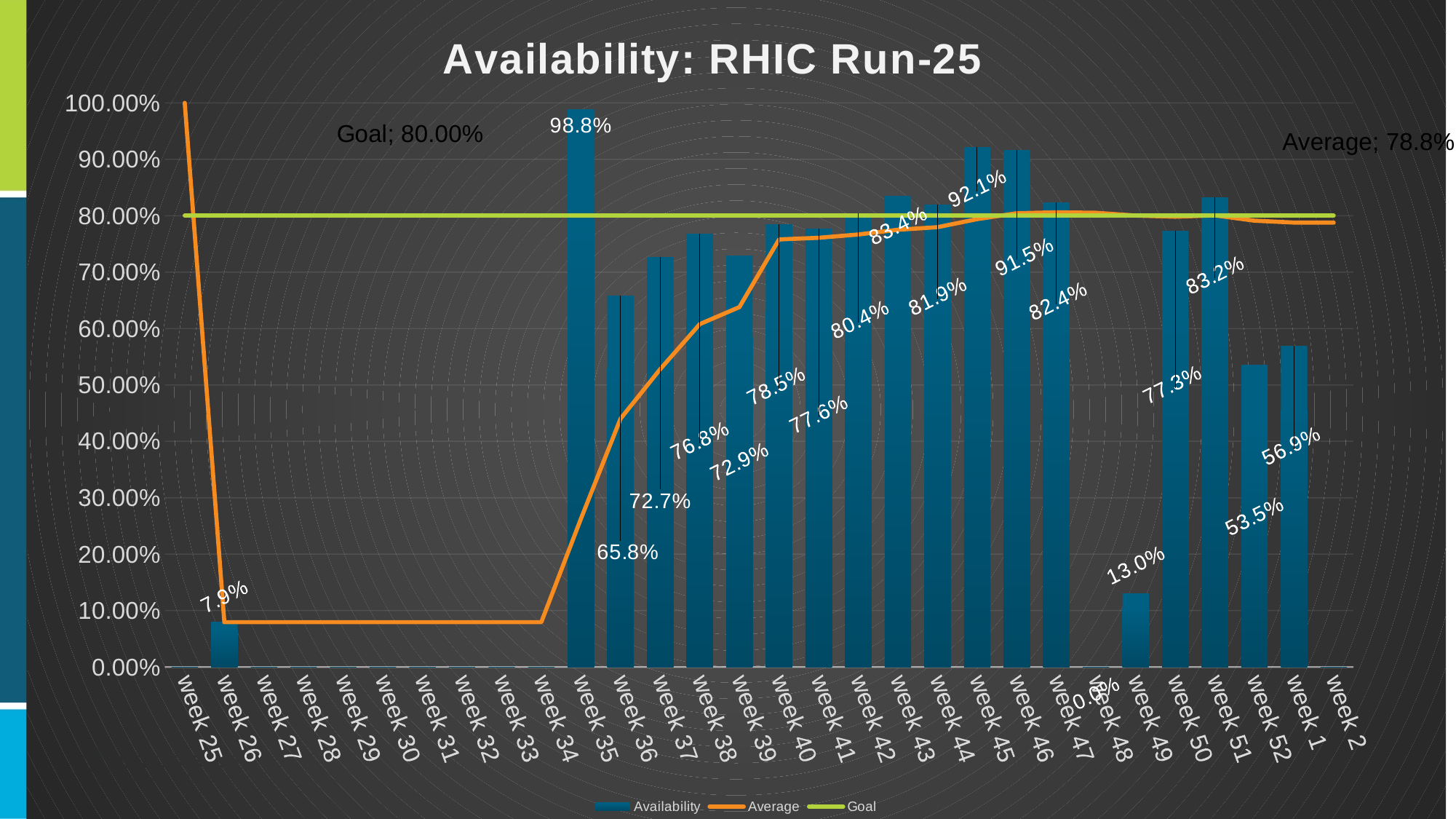
Is the availability for week 52 greater or less than 60.00%? less Which week has the highest availability? week 35 What value is shown for the Average? 78.8% What is the availability value for week 26? 7.9% How many series does the legend list? 3 What is the difference in availability between week 51 and week 50? 5.9% What is the availability value for week 35? 98.8% What value is shown for the Goal line? 80.00% What is the difference in availability between week 35 and week 36? 33.0% Which has the higher availability, week 42 or week 43? week 43 What is the availability value for week 49? 13.0% What is the availability value for week 1? 56.9%